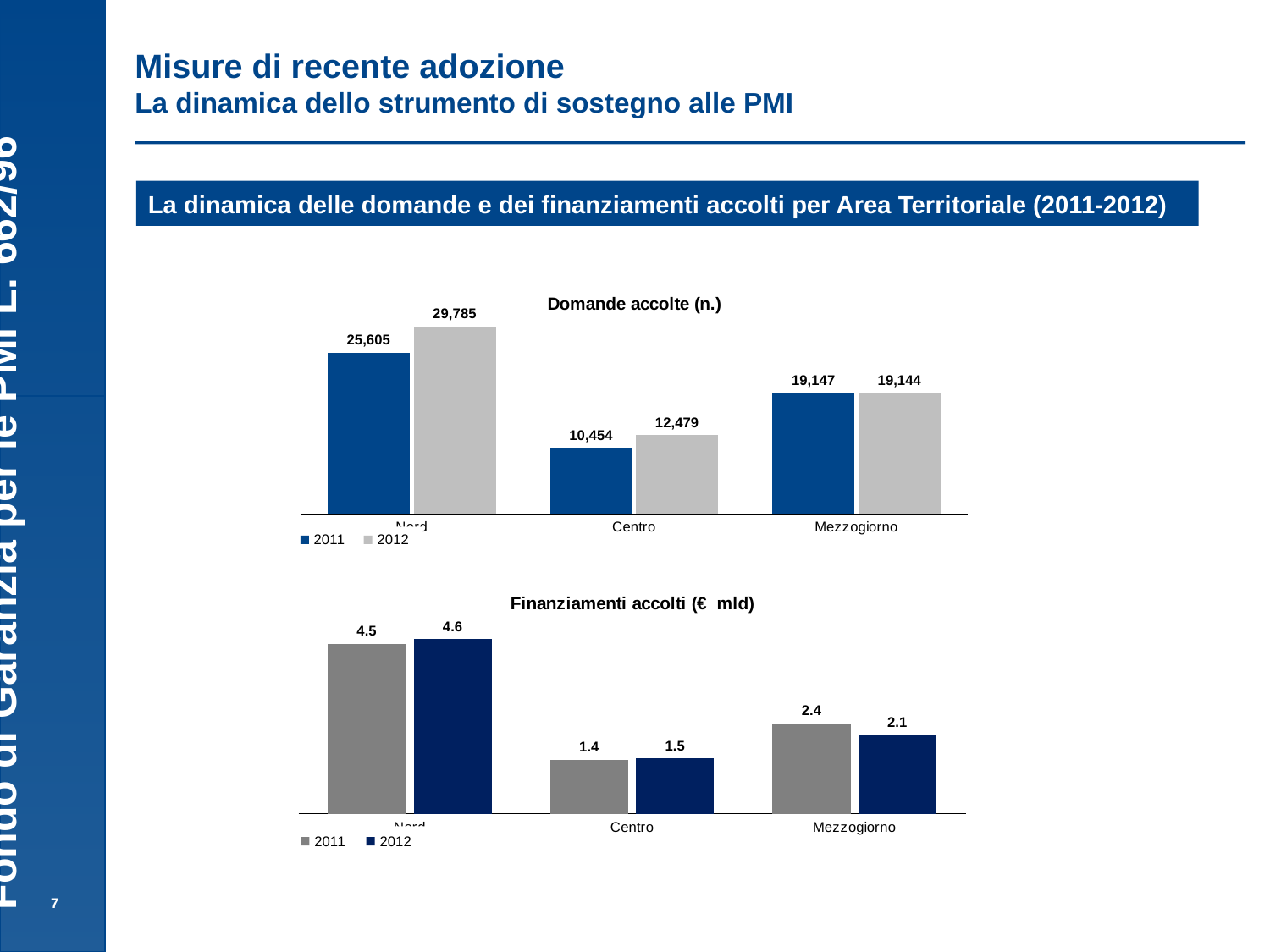
What kind of chart is the 'Finanziamenti accolti (€ mld)' chart? bar chart In the 'Domande accolte (n.)' chart, how many series does the legend list? 2 In the 'Finanziamenti accolti (€ mld)' chart, what is the 2011 value for Centro? 1.4 In the 'Finanziamenti accolti (€ mld)' chart, is the 2011 value for Mezzogiorno larger or smaller than the 2012 value for Mezzogiorno? larger In the 'Domande accolte (n.)' chart, what is the 2012 value for Centro? 12,479 In the 'Domande accolte (n.)' chart, which area has the highest 2012 value? Nord In the 'Domande accolte (n.)' chart, what is the 2011 value for Mezzogiorno? 19,147 In the 'Finanziamenti accolti (€ mld)' chart, what is the 2012 value for Mezzogiorno? 2.1 In the 'Domande accolte (n.)' chart, what is the difference between the 2012 and 2011 values for Nord? 4,180 In the 'Domande accolte (n.)' chart, which area has the lowest 2011 value? Centro In the 'Finanziamenti accolti (€ mld)' chart, what is the difference between the 2011 and 2012 values for Mezzogiorno? 0.3 In the 'Finanziamenti accolti (€ mld)' chart, how many areas are shown on the x axis? 3